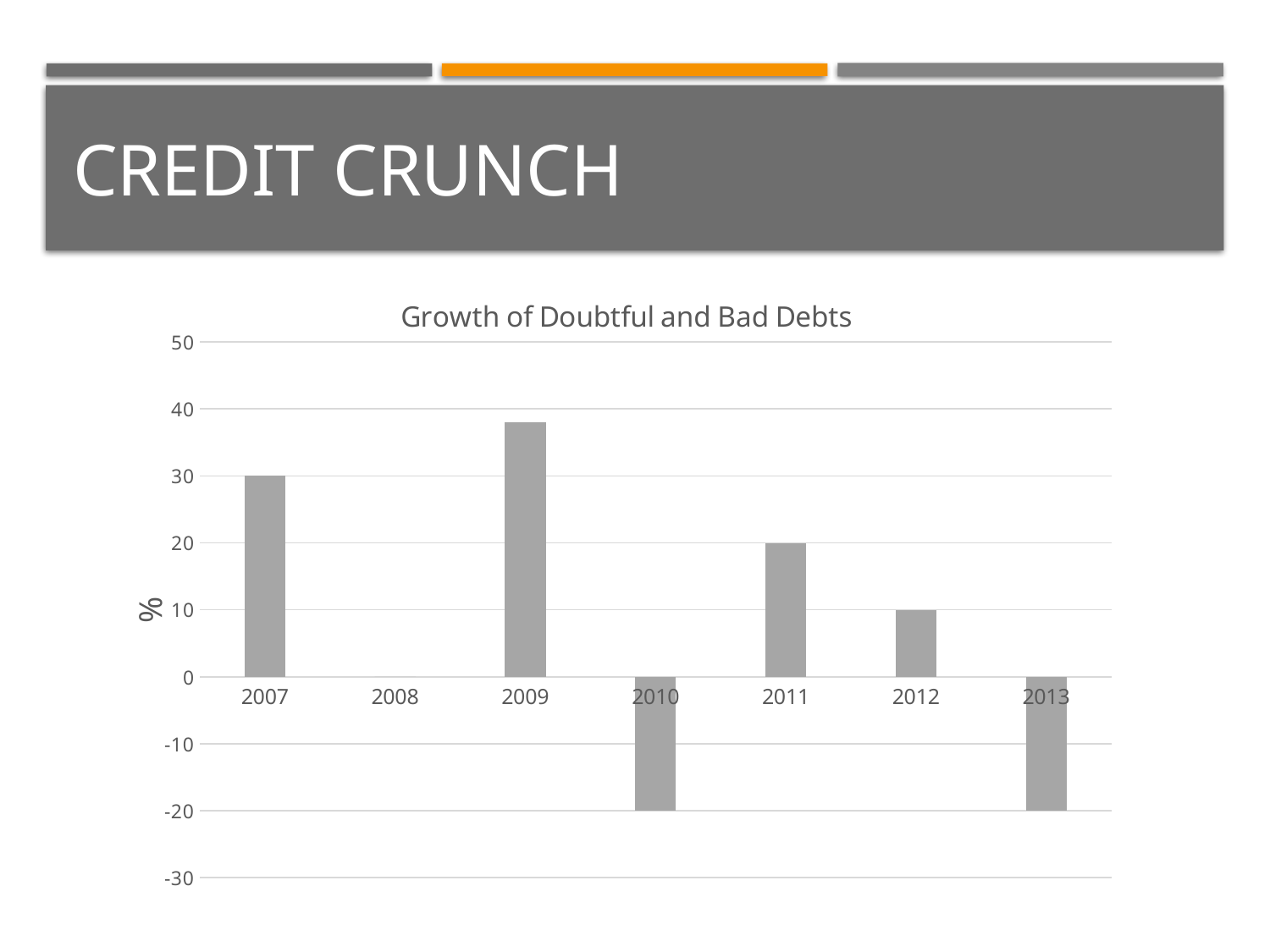
Which is larger, the value for 2007 or the value for 2011? 2007 What is the label on the vertical axis of the chart? % What is the value for 2007? 30 Is the value for 2009 greater or less than 30? greater What is the value for 2010? -20 Which year has the highest value? 2009 What is the difference between the values for 2011 and 2012? 10 What is the value for 2012? 10 What is the value for 2011? 20 What type of chart is shown on the slide? bar chart How many years are shown on the x axis of the chart? 7 What is the title of the chart? Growth of Doubtful and Bad Debts